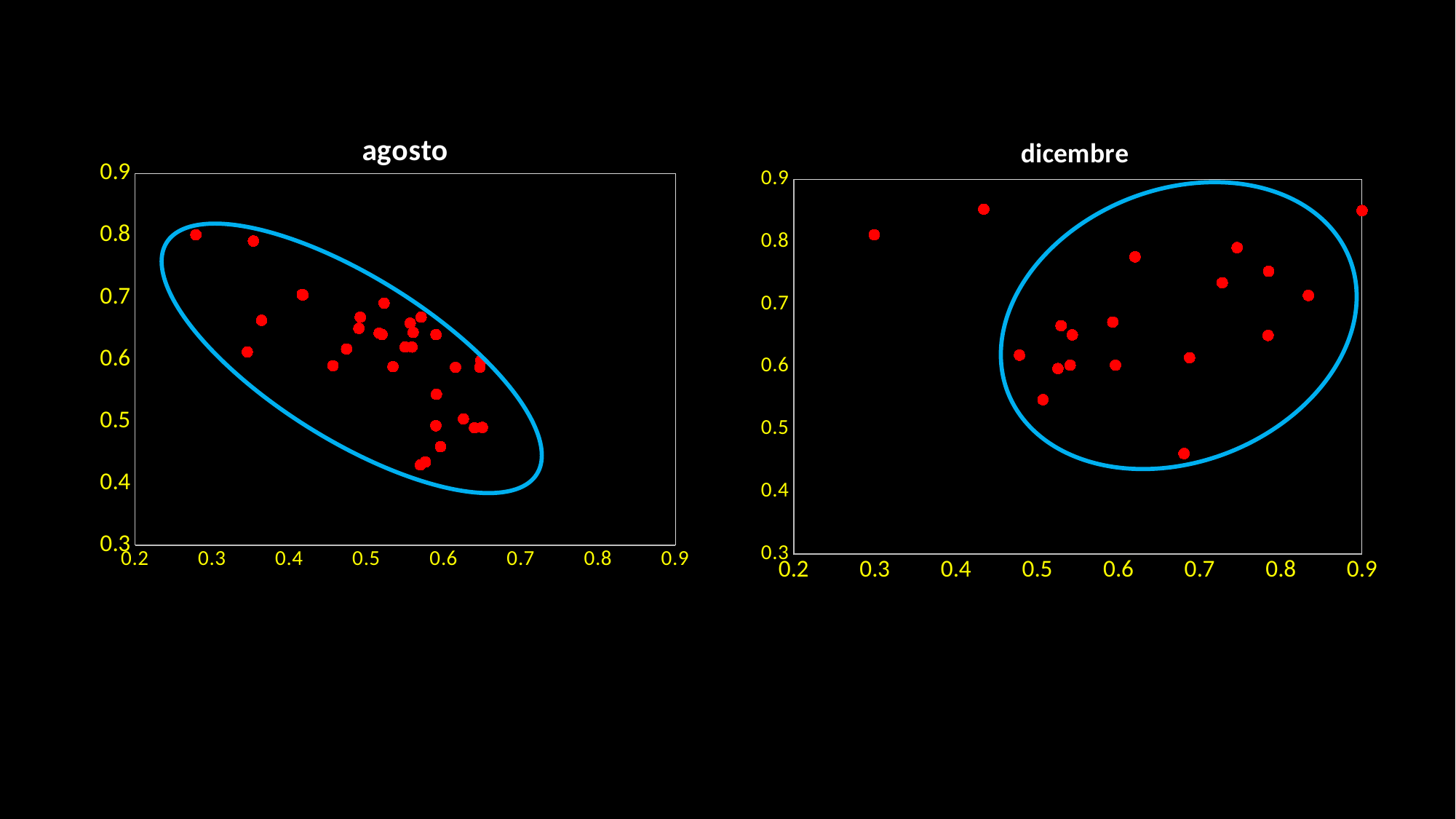
How many charts are shown on the slide? 2 In the chart titled "dicembre", what is the lowest value shown on the y axis? 0.3 What is the title of the chart on the right? dicembre In the chart titled "dicembre", what is the highest value shown on the x axis? 0.9 What kind of chart is the chart titled "agosto"? scatter plot In the chart titled "agosto", do the y values generally rise or fall as the x values increase? fall What kind of chart is the chart titled "dicembre"? scatter plot In the chart titled "dicembre", do the y values generally rise or fall as the x values increase? rise What is the title of the chart on the left? agosto In the chart titled "agosto", what is the lowest value shown on the x axis? 0.2 In the chart titled "agosto", what is the highest value shown on the y axis? 0.9